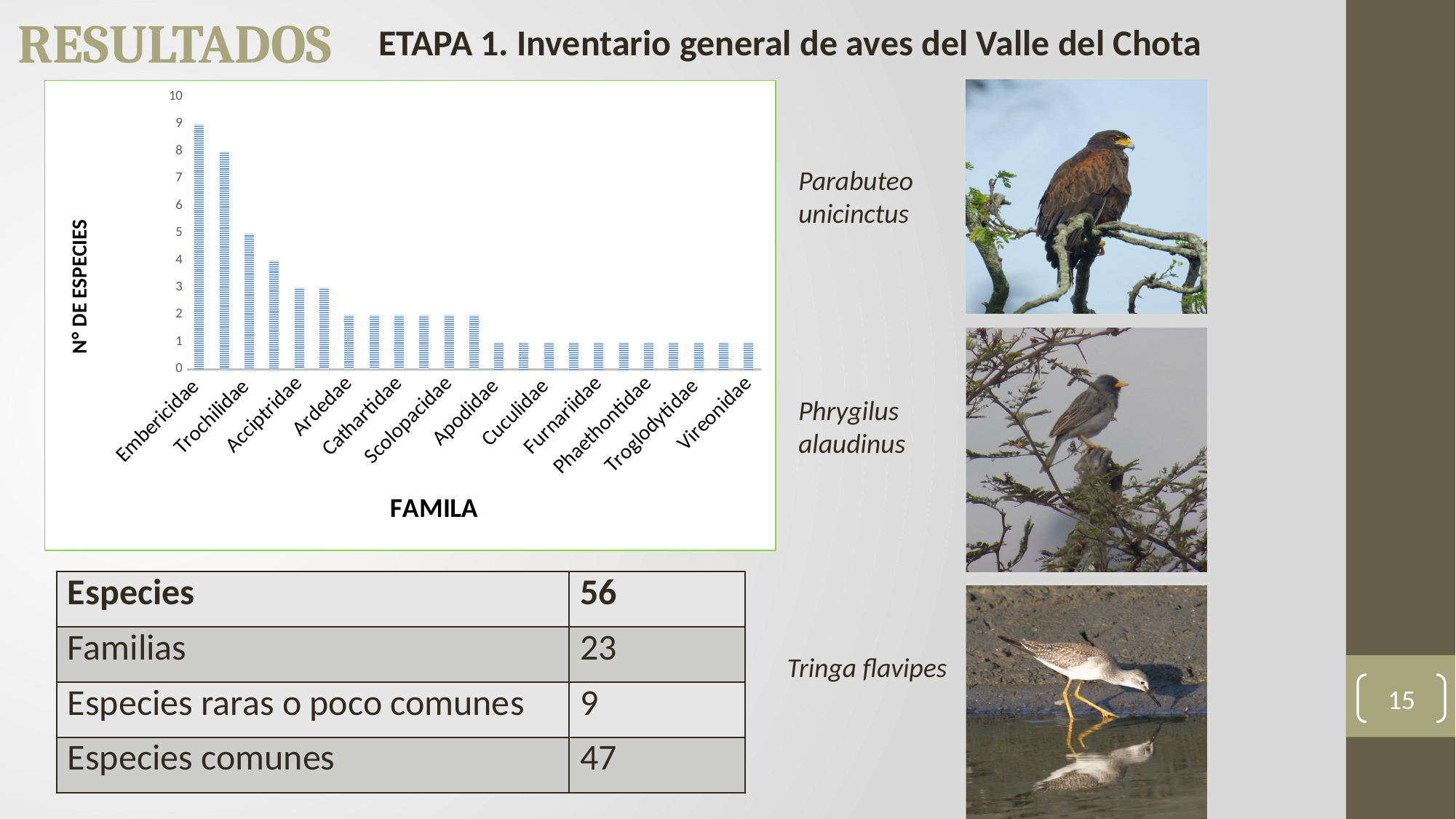
What is the number of species for Vireonidae? 1 What is the number of species for Trochilidae? 5 Which has more species, Embericidae or Acciptridae? Embericidae What is the difference in number of species between Embericidae and Trochilidae? 4 Which family has the highest number of species? Embericidae What kind of chart is shown on the slide? bar chart What is the title of the vertical axis? N° DE ESPECIES Do the values rise or fall from left to right along the x axis? fall What is the number of species for Embericidae? 9 Is the value for Trochilidae greater or less than 4? greater What is the title of the horizontal axis? FAMILA What is the number of species for Acciptridae? 3